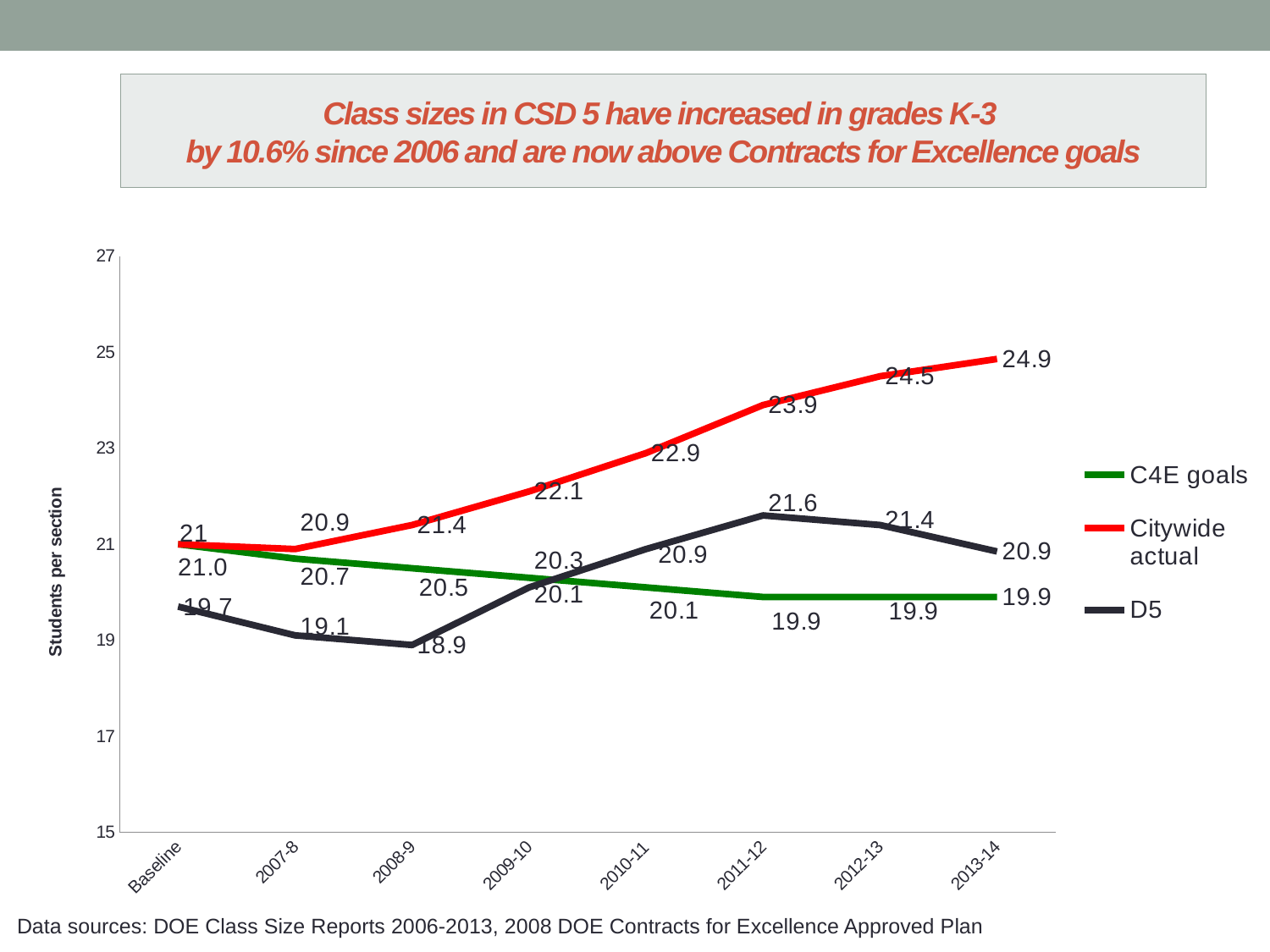
What is the D5 value for 2008-9? 18.9 In which year does the D5 series reach its lowest value? 2008-9 In 2012-13, which is larger: the D5 value or the C4E goals value? D5 Does the Citywide actual series generally rise or fall from 2007-8 to 2013-14? Rise What is the Citywide actual value for 2013-14? 24.9 What is the difference between the Citywide actual value and the D5 value in 2013-14? 4.0 How many series does the legend list? 3 What is the C4E goals value for 2009-10? 20.3 How many points are plotted along the x axis for each series? 8 What is the D5 value for 2011-12? 21.6 In which year does the D5 series reach its highest value? 2011-12 What kind of chart is shown on the slide? Line chart